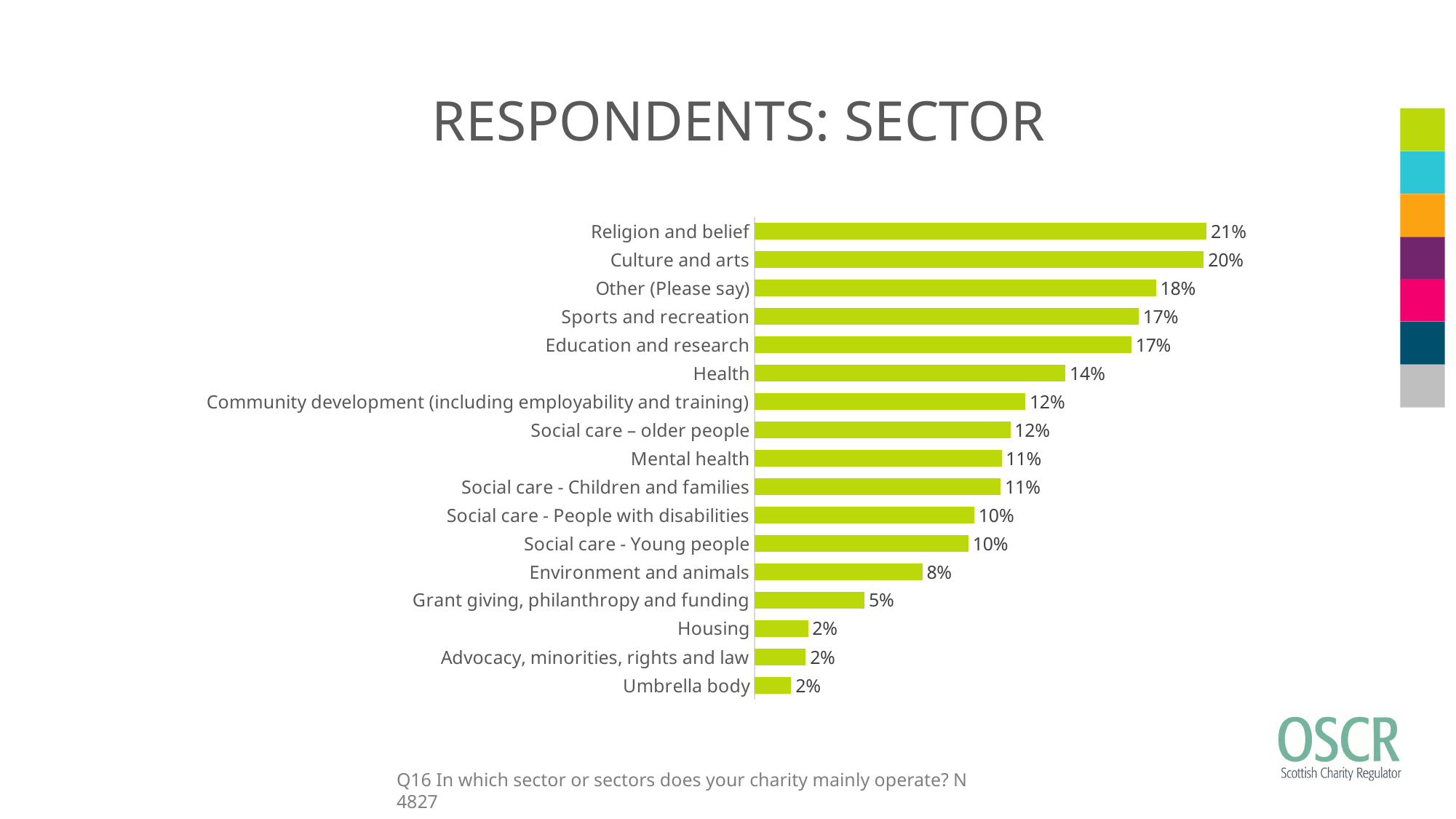
Which has a larger value, Sports and recreation or Mental health? Sports and recreation What percentage of respondents operate in the Religion and belief sector? 21% What percentage is shown for Grant giving, philanthropy and funding? 5% What is the title of the slide? RESPONDENTS: SECTOR How many sector categories are shown in the chart? 17 What is the difference between the values for Other (Please say) and Housing? 16% What is the difference between the values for Culture and arts and Environment and animals? 12% What colour are the bars in the chart? Green What is the value shown for Social care – older people? 12% What is the value shown for Health? 14% Which sector has the highest percentage of respondents? Religion and belief What kind of chart is shown on the slide? Bar chart